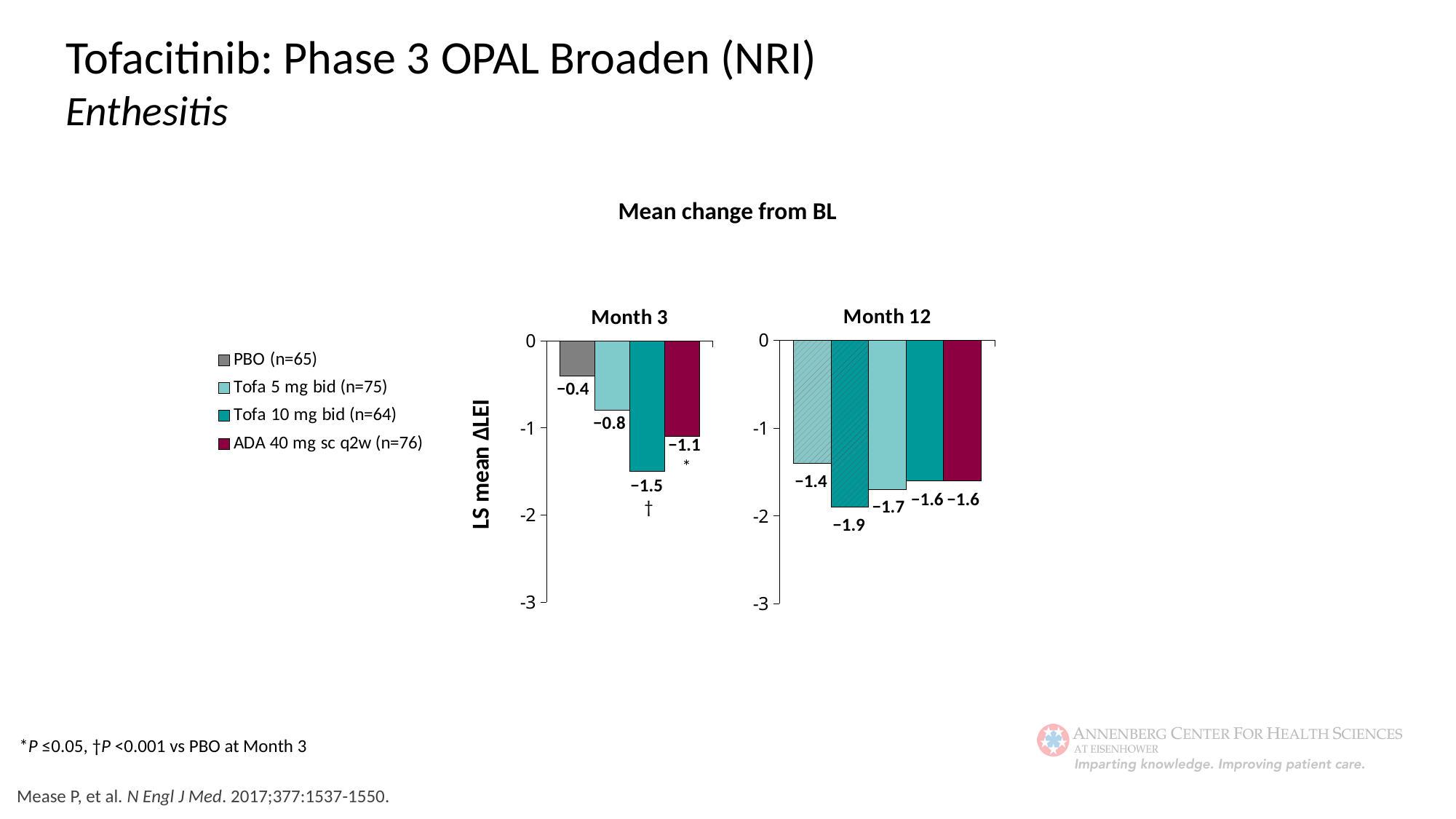
In the Month 3 chart, what is the LS mean change in LEI for PBO? −0.4 In the Month 3 chart, which shows a larger reduction in LEI: Tofa 5 mg bid or ADA 40 mg sc q2w? ADA 40 mg sc q2w In the Month 3 chart, what is the LS mean change in LEI for ADA 40 mg sc q2w? −1.1 How many treatment groups does the legend list? 4 In the Month 12 chart, what is the LS mean change in LEI for the solid Tofa 5 mg bid bar? −1.7 In the Month 3 chart, which treatment group shows the smallest reduction in LEI? PBO In the Month 3 chart, what is the LS mean change in LEI for Tofa 10 mg bid? −1.5 In the Month 3 chart, which treatment group shows the largest reduction in LEI? Tofa 10 mg bid In the Month 3 chart, what is the difference between the Tofa 10 mg bid value and the PBO value? 1.1 How many bars are plotted in the Month 12 chart? 5 What type of chart is used to show the mean change from baseline? Bar chart In the Month 12 chart, what is the LS mean change in LEI for ADA 40 mg sc q2w? −1.6